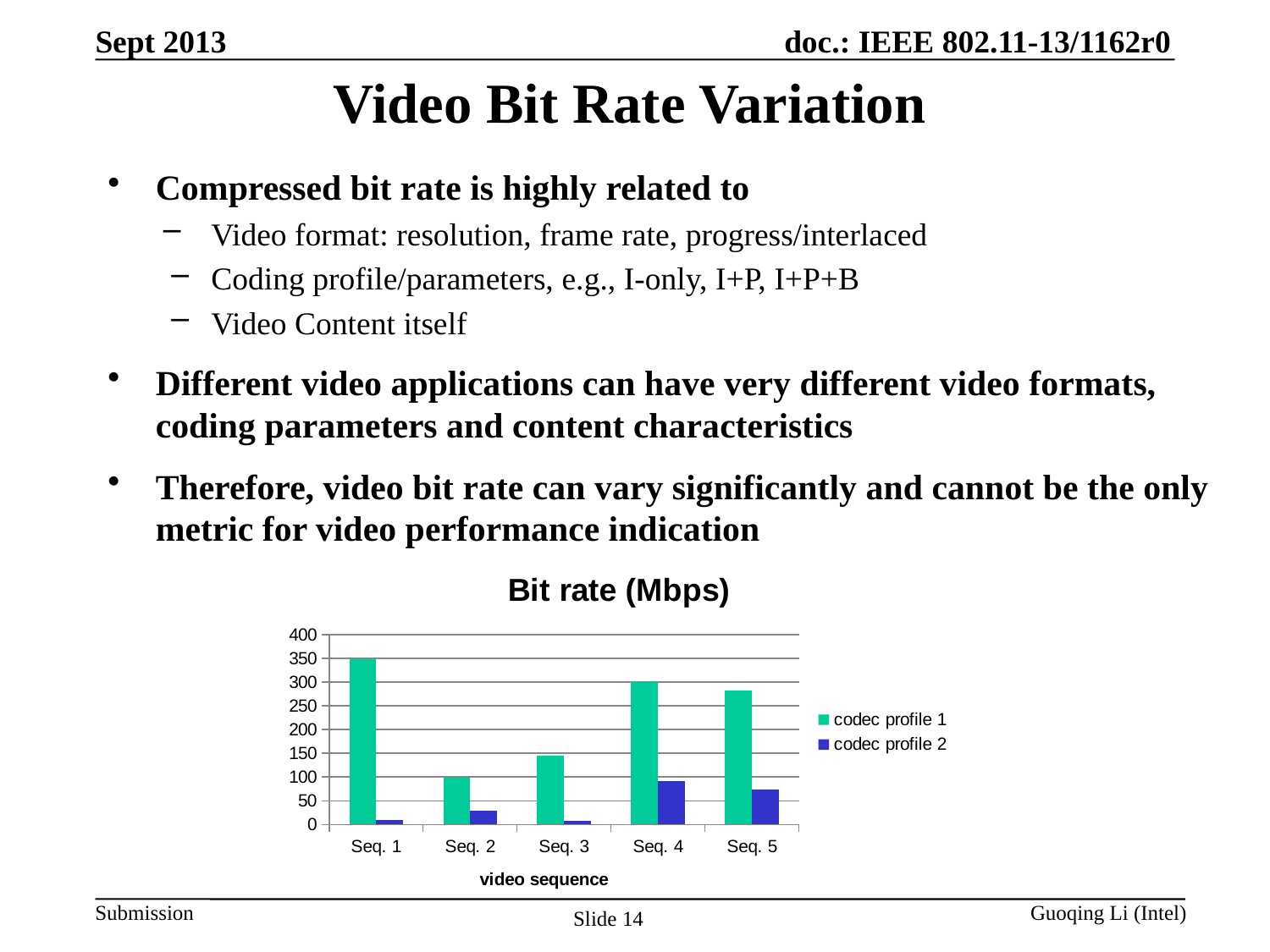
Which video sequence has the highest bit rate for codec profile 2? Seq. 4 Which video sequence has the lowest bit rate for codec profile 1? Seq. 2 What is the label of the x axis of the chart? video sequence How many series does the chart legend list? 2 How many video sequences are shown on the x axis of the chart? 5 Is the codec profile 2 bit rate for Seq. 4 greater or less than 50? greater Which video sequence has the highest bit rate for codec profile 1? Seq. 1 Is the codec profile 1 bit rate for Seq. 1 greater or less than 300? greater What kind of chart is shown on the slide? bar chart What is the title of the chart? Bit rate (Mbps) For codec profile 1, which has the larger bit rate, Seq. 2 or Seq. 3? Seq. 3 Is the codec profile 1 bit rate for Seq. 2 greater or less than 150? less